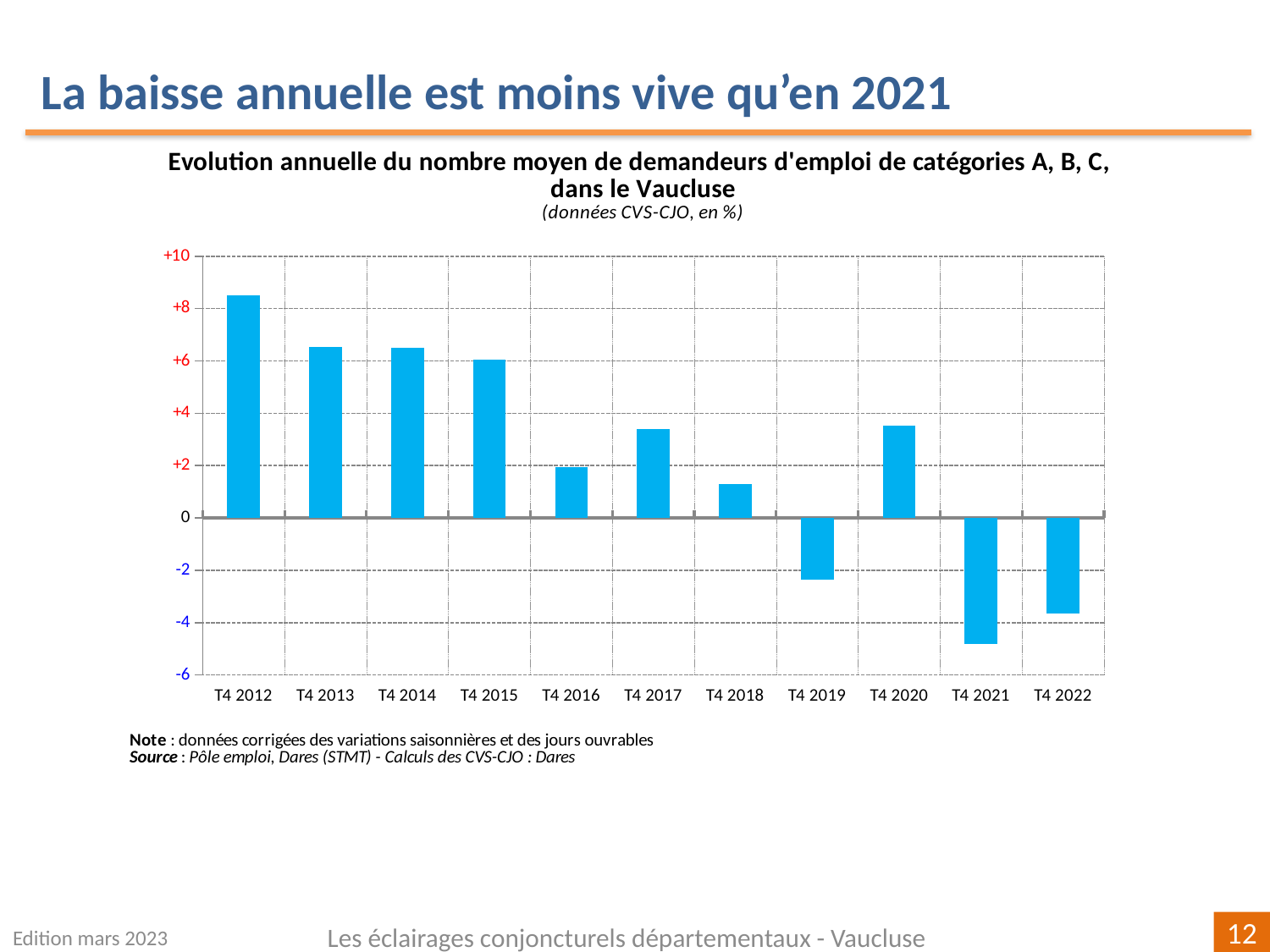
Is the value for T4 2012 greater or less than +8? greater Is the value for T4 2021 greater or less than -4? less In what unit are the data expressed, according to the chart subtitle? en % Which is lower, the value for T4 2021 or the value for T4 2022? T4 2021 How many periods (categories) are plotted on the x axis? 11 Which is larger, the value for T4 2012 or the value for T4 2016? T4 2012 Is the value for T4 2018 greater or less than +2? less Which period has the highest value? T4 2012 What kind of chart is shown on the slide? Bar chart How many periods show a negative value? 3 Which period has the lowest value? T4 2021